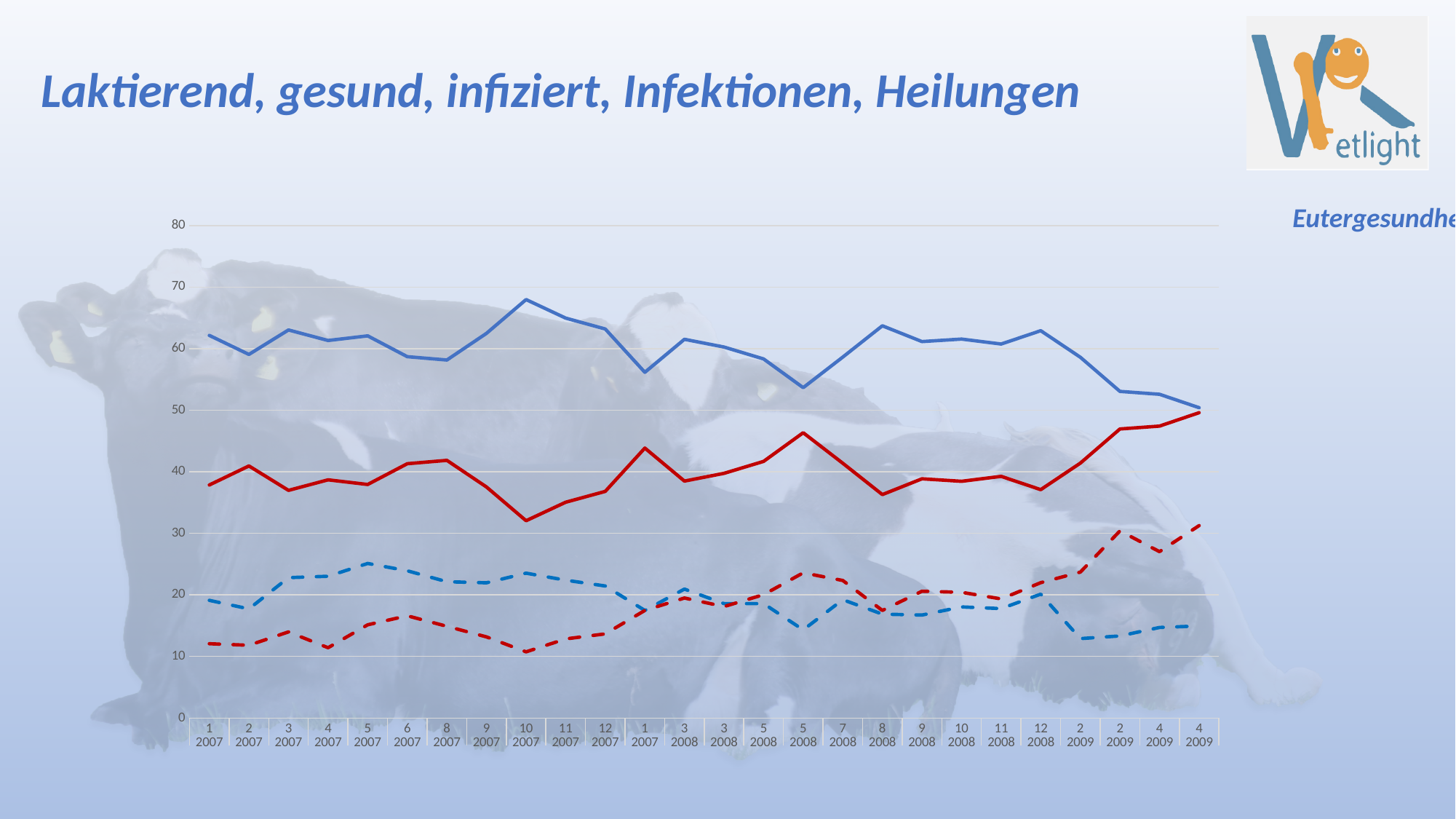
At which x-axis point does the solid red line reach its lowest value? 10 2007 Is the value of the solid blue line at 10 2007 greater or less than 60? greater How many lines are plotted on the chart? 4 What kind of chart is shown on the slide? line chart What is the title of the slide containing the chart? Laktierend, gesund, infiziert, Infektionen, Heilungen Is the value of the solid red line at 10 2007 greater or less than 40? less At which x-axis point does the solid blue line reach its highest value? 10 2007 Is the value of the dashed red line at the first point (1 2007) greater or less than 20? less What is the highest value shown on the y axis of the chart? 80 At the first point (1 2007), which is larger: the solid blue line or the solid red line? solid blue line How many data points are listed along the x axis of the chart? 26 Does the solid blue line rise or fall from 12 2008 to the last point (4 2009)? fall